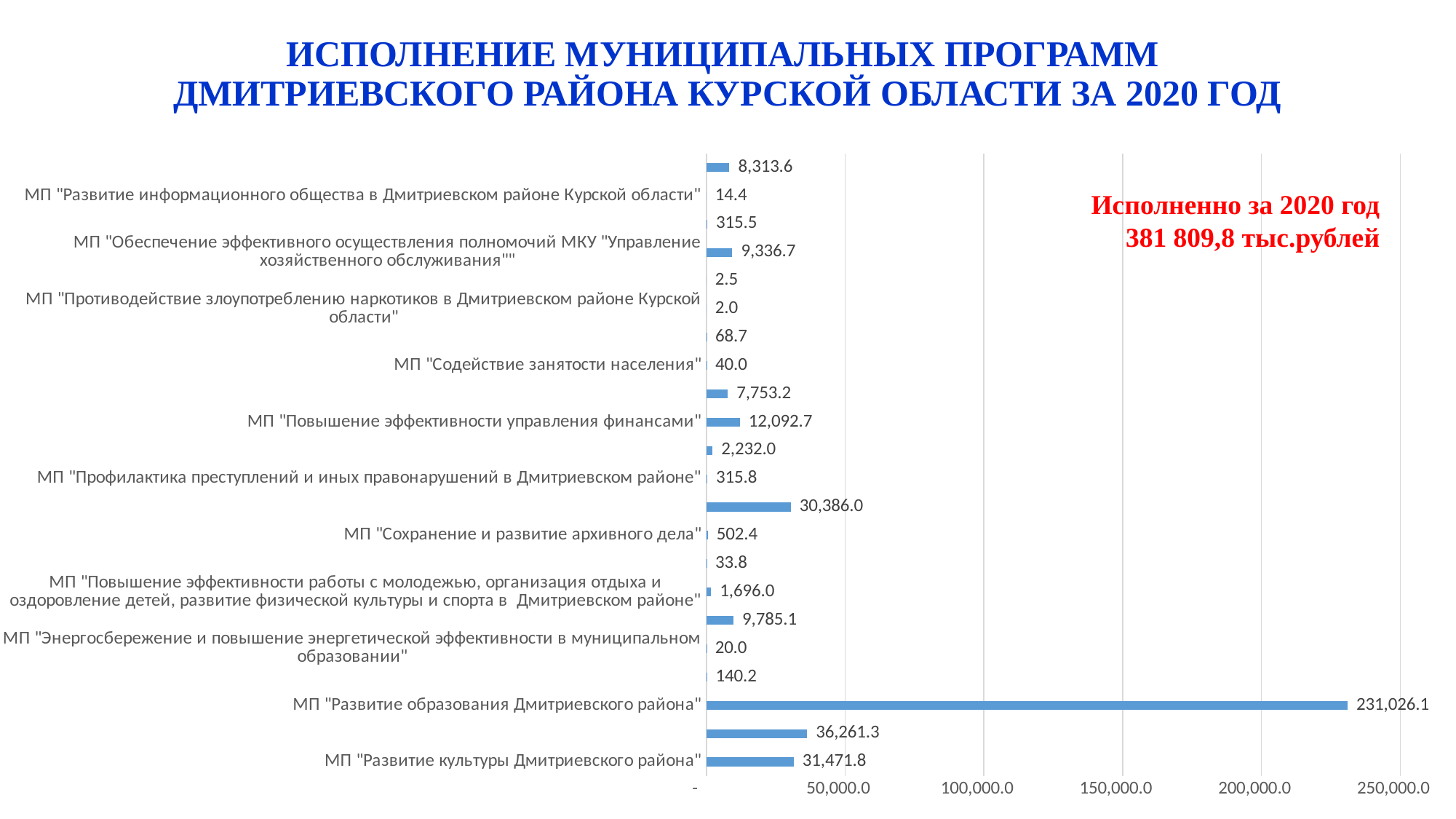
How many bars are plotted on the chart? 22 What kind of chart is shown on the slide? bar chart What is the value for МП "Развитие культуры Дмитриевского района"? 31,471.8 What is the difference between the values for МП "Развитие образования Дмитриевского района" and МП "Развитие культуры Дмитриевского района"? 199,554.3 Is the value for МП "Развитие образования Дмитриевского района" greater or less than 200,000.0? greater According to the red text on the slide, what total amount was executed for 2020? 381 809,8 тыс.рублей What is the value for МП "Сохранение и развитие архивного дела"? 502.4 Which is larger: the value for МП "Повышение эффективности управления финансами" or МП "Обеспечение эффективного осуществления полномочий МКУ "Управление хозяйственного обслуживания""? МП "Повышение эффективности управления финансами" What is the value for МП "Содействие занятости населения"? 40.0 What is the value for МП "Повышение эффективности управления финансами"? 12,092.7 Which program has the highest value on the chart? МП "Развитие образования Дмитриевского района" What is the value for МП "Развитие образования Дмитриевского района"? 231,026.1